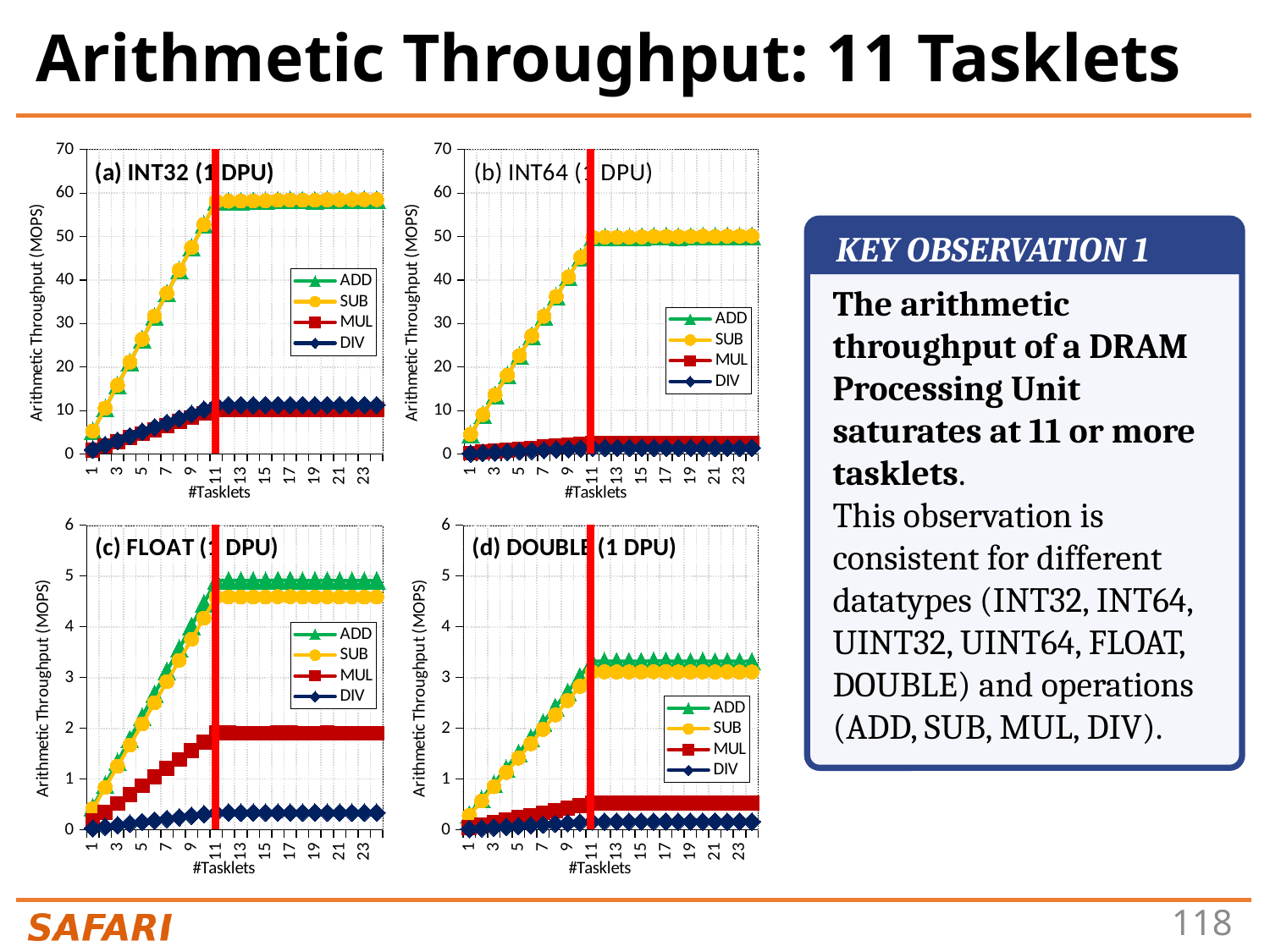
In chart (c) FLOAT (1 DPU), is the value for ADD at 23 tasklets greater or less than 4? greater In chart (d) DOUBLE (1 DPU), is the value for MUL at 23 tasklets greater or less than 1? less In chart (c) FLOAT (1 DPU), which is larger at 23 tasklets, MUL or DIV? MUL In chart (d) DOUBLE (1 DPU), how does the ADD throughput change as the number of tasklets increases from 1 to 11? It rises In chart (a) INT32 (1 DPU), is the value for ADD at 23 tasklets greater or less than 50? greater What is the y-axis label of chart (c) FLOAT (1 DPU)? Arithmetic Throughput (MOPS) How many series does the legend of chart (b) INT64 (1 DPU) list? 4 In chart (c) FLOAT (1 DPU), which series has the lowest throughput at 23 tasklets? DIV What kind of chart is chart (a) INT32 (1 DPU)? line chart